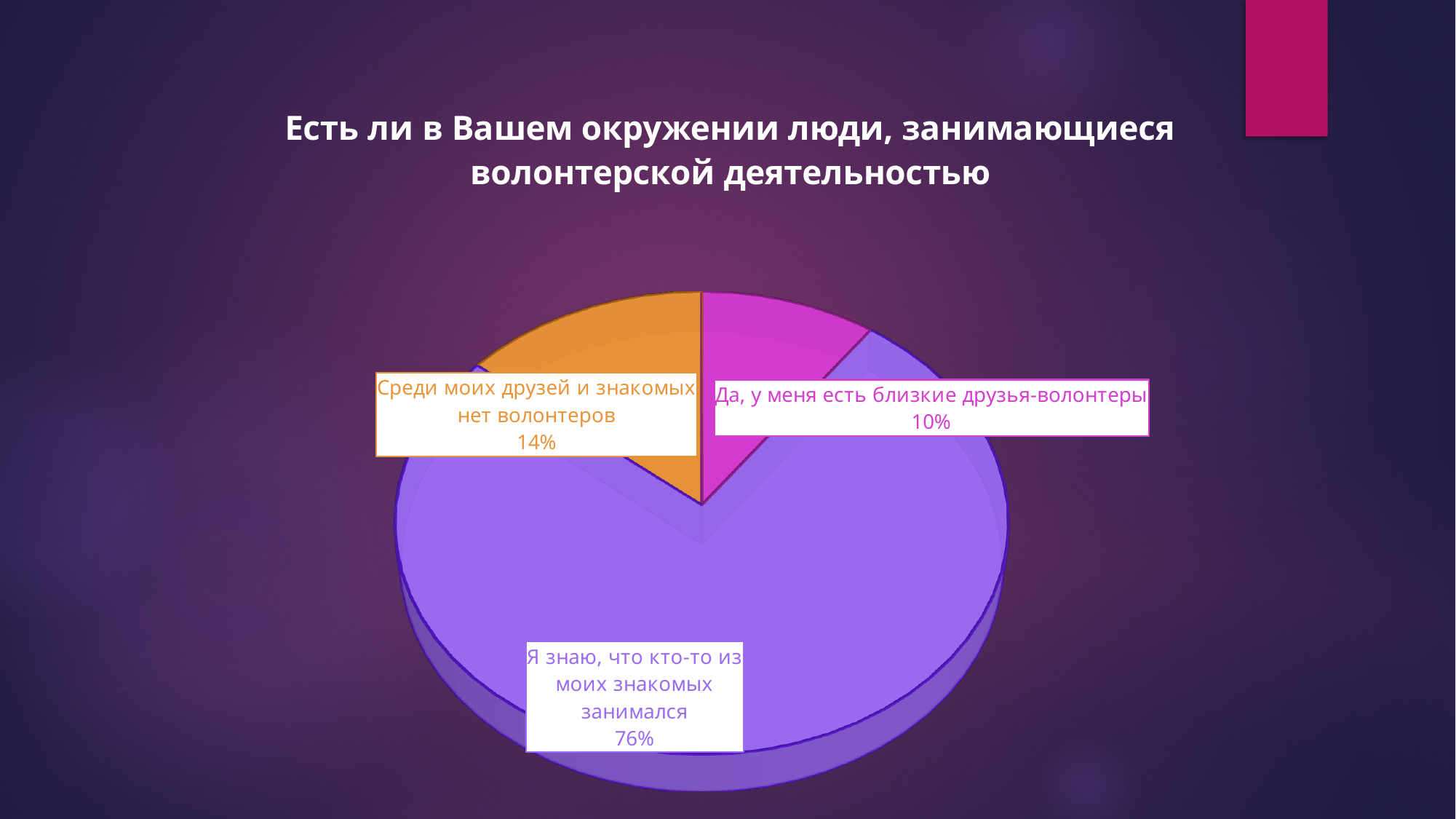
What share of the pie is labelled "Да, у меня есть близкие друзья-волонтеры"? 10% What colour is the slice labelled "Среди моих друзей и знакомых нет волонтеров"? orange Which slice of the pie is the smallest? Да, у меня есть близкие друзья-волонтеры How many slices does the pie chart have? 3 What is the title of the slide above the pie chart? Есть ли в Вашем окружении люди, занимающиеся волонтерской деятельностью What is the difference in percentage points between the "Среди моих друзей и знакомых нет волонтеров" slice and the "Да, у меня есть близкие друзья-волонтеры" slice? 4 Which is larger: the "Среди моих друзей и знакомых нет волонтеров" slice or the "Да, у меня есть близкие друзья-волонтеры" slice? Среди моих друзей и знакомых нет волонтеров Which slice of the pie is the largest? Я знаю, что кто-то из моих знакомых занимался What share of the pie is labelled "Я знаю, что кто-то из моих знакомых занимался"? 76% What kind of chart is shown on the slide? pie chart What is the difference in percentage points between the "Я знаю, что кто-то из моих знакомых занимался" slice and the "Среди моих друзей и знакомых нет волонтеров" slice? 62 What share of the pie is labelled "Среди моих друзей и знакомых нет волонтеров"? 14%